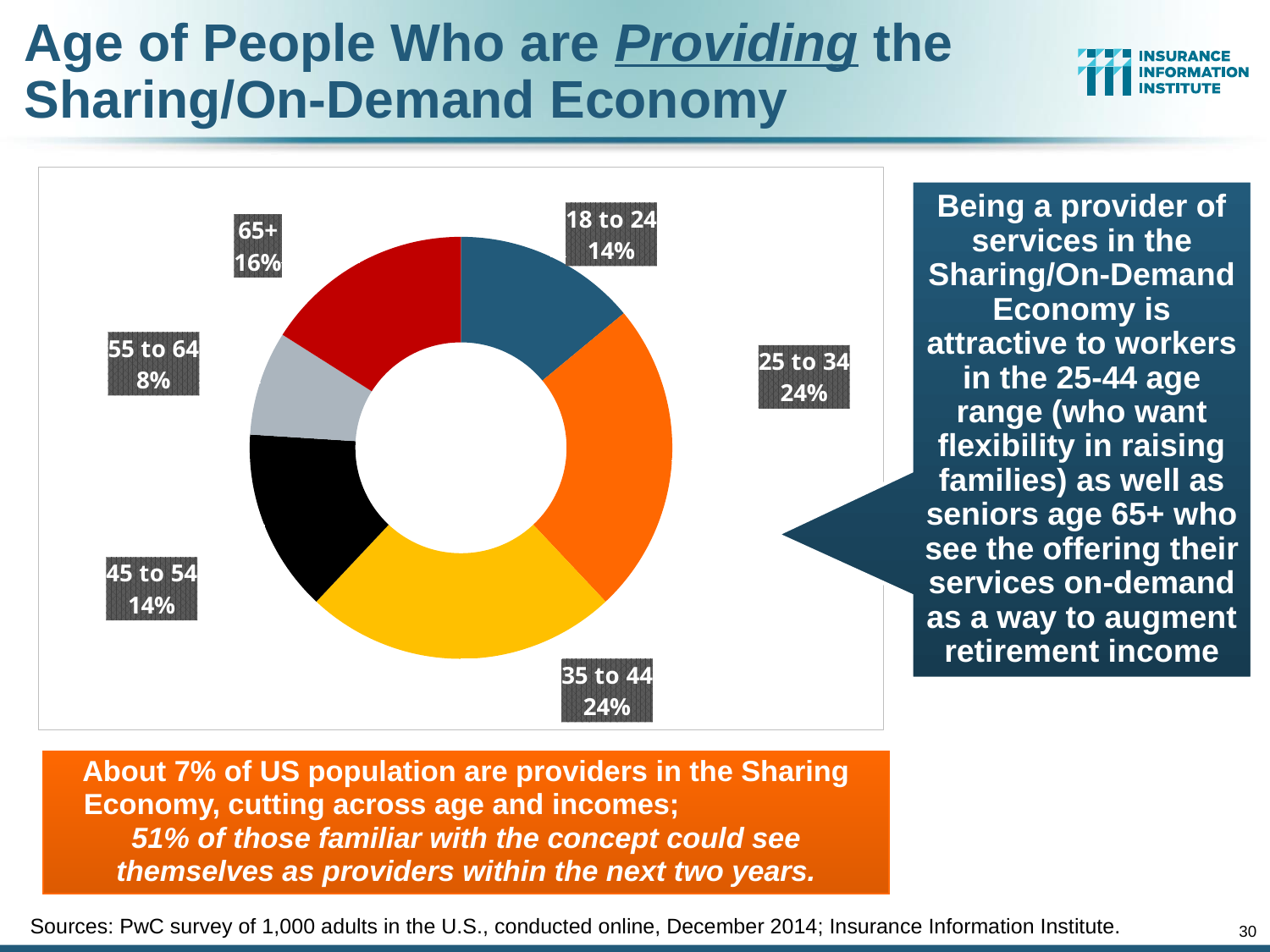
What kind of chart is used to show the age of providers? doughnut chart What is the combined share of the 25 to 34 and 35 to 44 age groups? 48% What percentage of providers are in the 25 to 34 age group? 24% Which is larger, the share for 65+ or the share for 55 to 64? 65+ What share of providers in the Sharing/On-Demand Economy are aged 18 to 24? 14% Which age group has the smallest share of providers? 55 to 64 How many age groups are shown in the chart? 6 What is the difference in percentage points between the 65+ group and the 45 to 54 group? 2 What is the value shown for the 55 to 64 age group? 8% What share of providers are aged 65+? 16% Which is larger, the share for 25 to 34 or the share for 18 to 24? 25 to 34 What is the difference in percentage points between the 35 to 44 group and the 55 to 64 group? 16